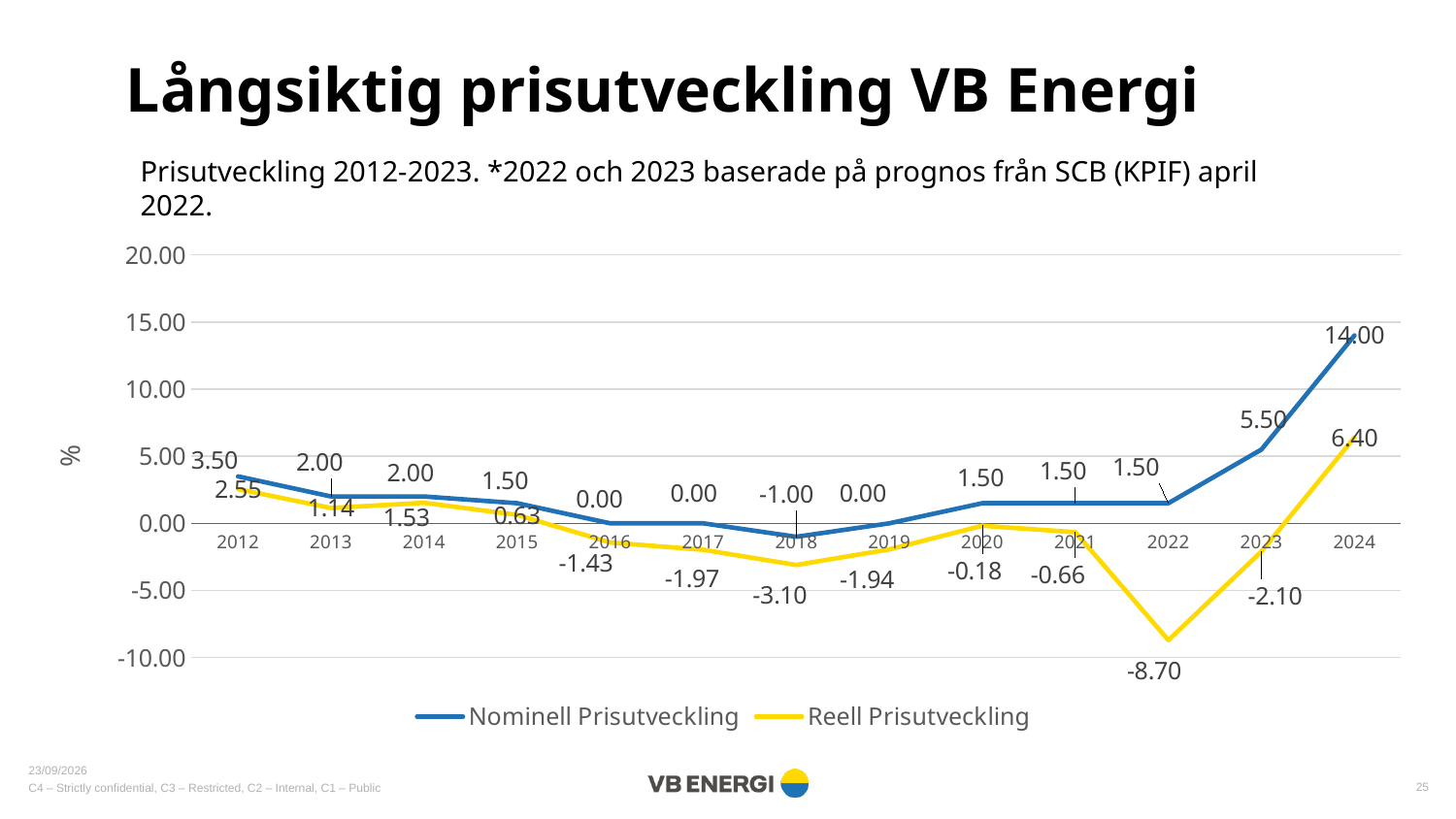
What type of chart is shown on the slide? line chart What is the value of Reell Prisutveckling in 2018? -3.10 What is the label on the y axis? % In which year is Nominell Prisutveckling highest? 2024 Which is larger in 2023: Nominell Prisutveckling or Reell Prisutveckling? Nominell Prisutveckling What is the value of Nominell Prisutveckling in 2012? 3.50 In which year is Reell Prisutveckling lowest? 2022 What is the value of Nominell Prisutveckling in 2024? 14.00 How many years are plotted on the x axis? 13 What is the value of Reell Prisutveckling in 2022? -8.70 How many series does the legend list? 2 What is the difference between Nominell Prisutveckling and Reell Prisutveckling in 2024? 7.60